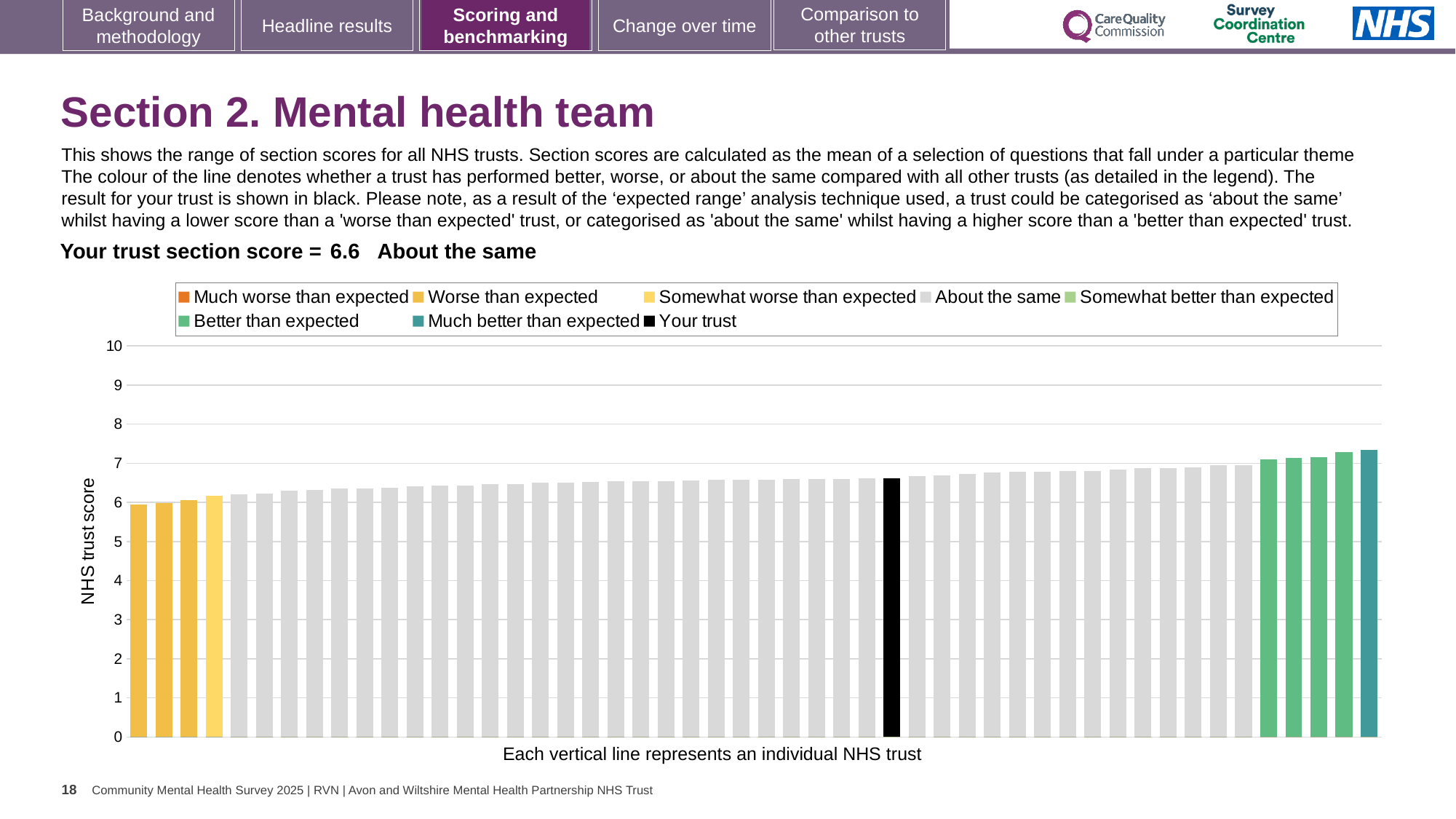
What colour is the bar representing your trust? black How many bars are coloured as 'Worse than expected'? 3 How many bars are coloured as 'Much better than expected'? 1 What is the label on the y axis of the chart? NHS trust score Is the value for your trust greater or less than 6? greater Do the bar values rise or fall from left to right along the x axis? rise Which category is your trust's section score placed in? About the same What is the section score for your trust? 6.6 Is the value of the tallest bar greater or less than 7? greater Is the value for your trust greater or less than 7? less What kind of chart is shown on the slide? bar chart How many entries does the chart legend list? 8